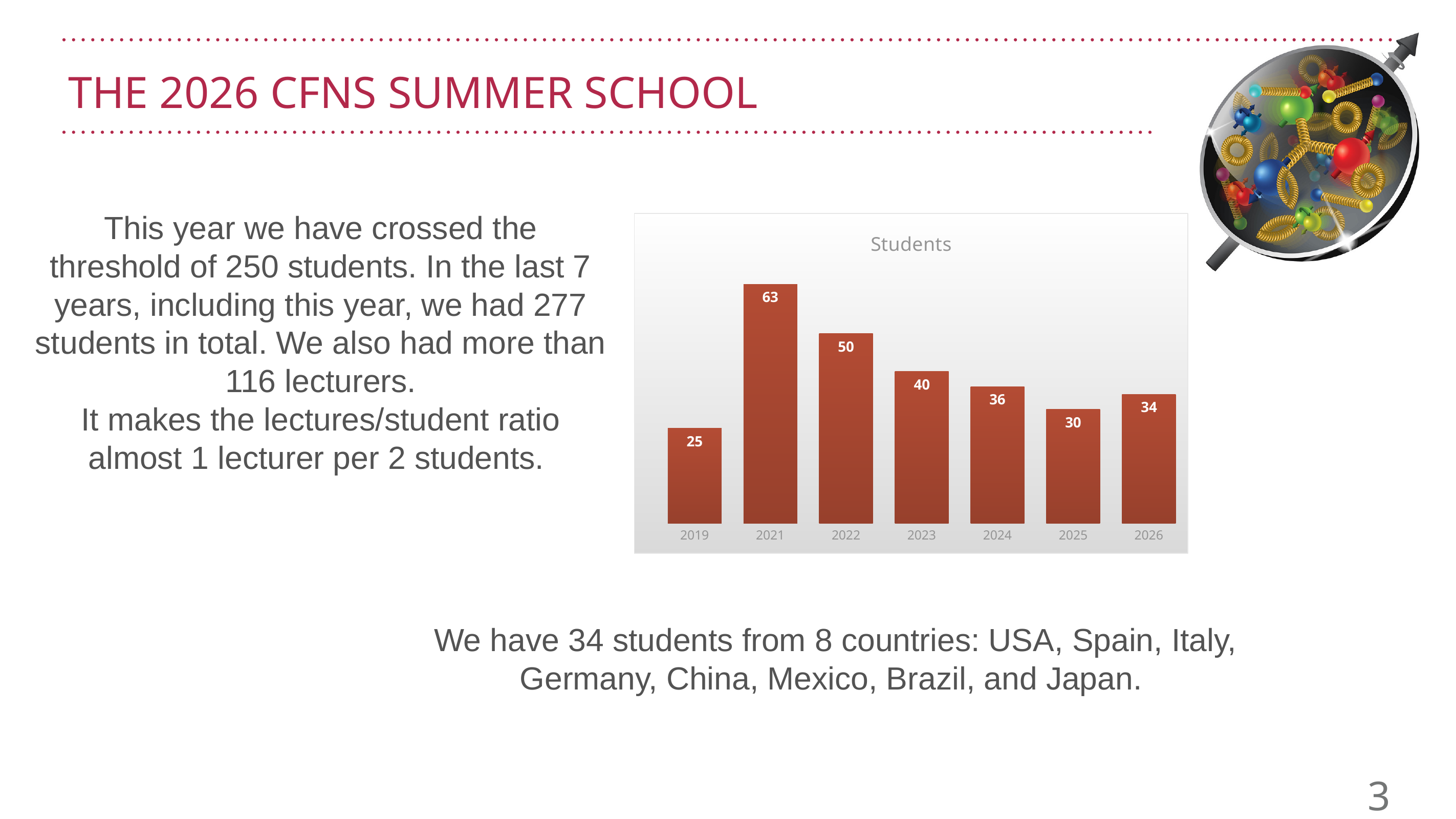
Which year had more students, 2023 or 2024? 2023 How many years are shown on the x axis of the chart? 7 What is the number of students shown for 2021? 63 Do the student numbers rise or fall from 2021 to 2025? Fall What is the number of students shown for 2026? 34 What kind of chart is shown on the slide? Bar chart What is the difference in students between 2026 and 2025? 4 Which year has the lowest number of students? 2019 What is the difference in students between 2021 and 2022? 13 Which year has the highest number of students? 2021 What is the title of the chart? Students What is the number of students shown for 2019? 25